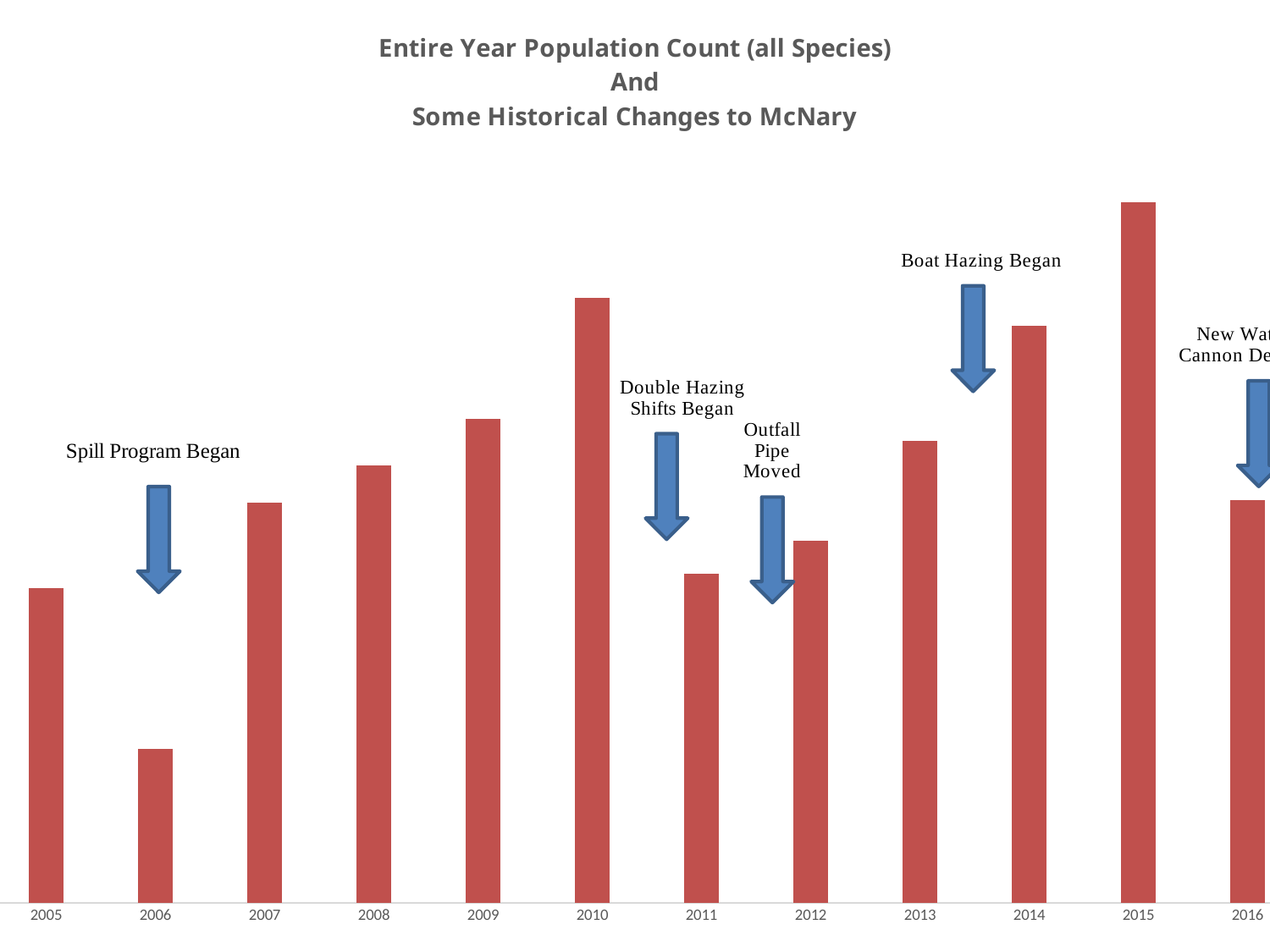
Which year has the larger population count, 2011 or 2012? 2012 What kind of chart is shown on the slide? Bar chart Which year has the lowest population count? 2006 Which year has the larger population count, 2009 or 2010? 2010 Which year has the highest population count? 2015 Do the population counts rise or fall from 2011 to 2015? Rise How many years are plotted on the x axis? 12 Which historical change is annotated above the 2006 bar? Spill Program Began Which year has the larger population count, 2013 or 2014? 2014 What is the title of the chart? Entire Year Population Count (all Species) And Some Historical Changes to McNary Do the population counts rise or fall from 2006 to 2010? Rise